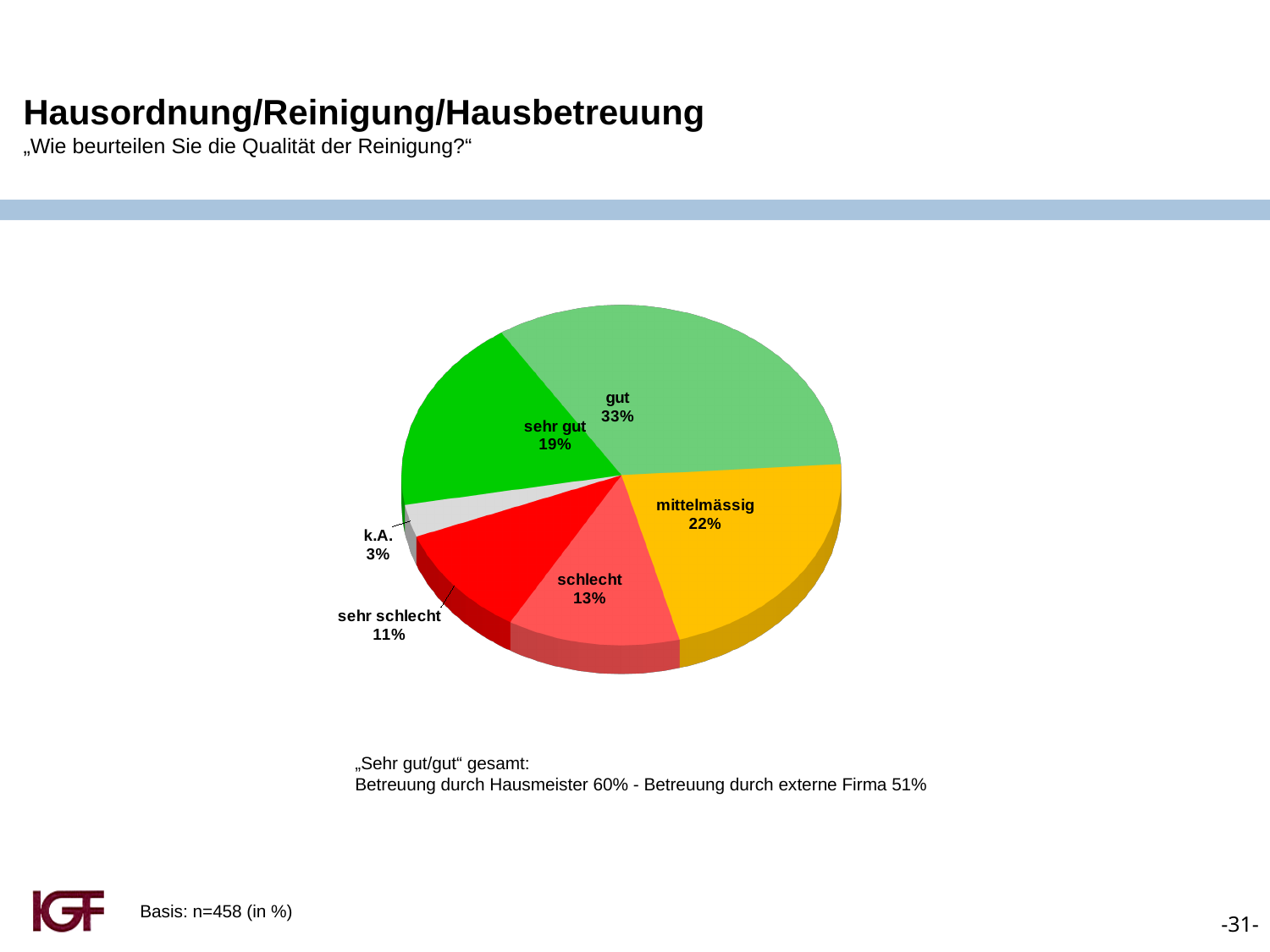
What is the share for "sehr gut"? 19% What is the difference in percentage points between "gut" and "schlecht"? 20 What colour is the "mittelmässig" slice? yellow What is the value for "sehr schlecht"? 11% Which category has the largest slice of the pie? gut How many categories are shown in the pie chart? 6 What percentage is shown for "mittelmässig"? 22% Which is larger, the share for "mittelmässig" or the share for "sehr gut"? mittelmässig What percentage is labelled "k.A."? 3% Which category has the smallest slice of the pie? k.A. What type of chart is shown on the slide? pie chart What percentage of respondents rated the cleaning quality as "gut"? 33%